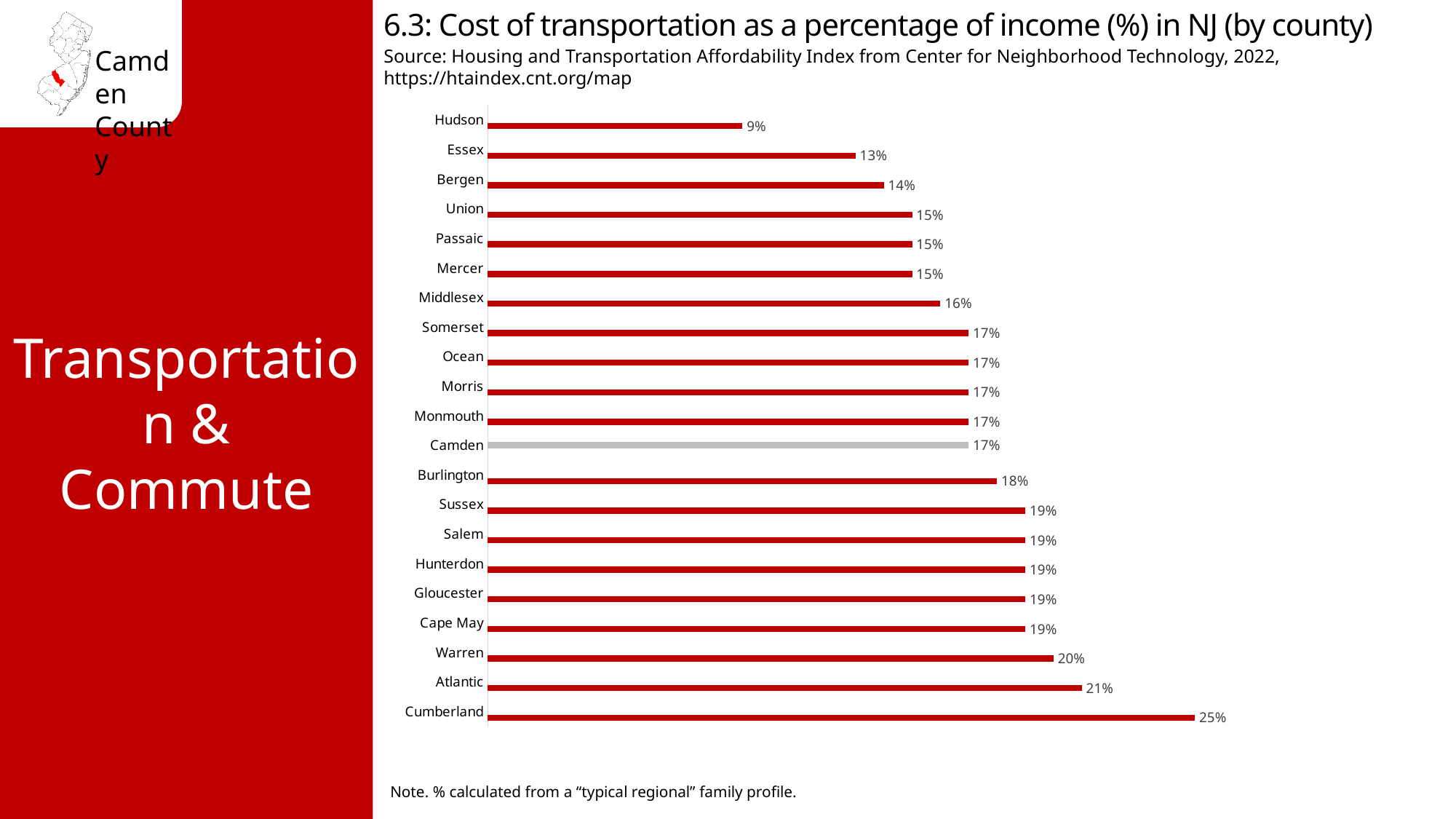
Which county has the lowest cost of transportation as a percentage of income? Hudson What is the value shown for Atlantic County? 21% Which county's bar is shown in grey rather than red? Camden Which county has the highest cost of transportation as a percentage of income? Cumberland How many counties are shown in the chart? 21 What is the difference between the values for Cumberland and Hudson? 16 percentage points Which has a higher value, Middlesex or Bergen? Middlesex What is the value shown for Hudson County? 9% What kind of chart is shown on the slide? Bar chart Which has a higher value, Essex or Burlington? Burlington What is the cost of transportation as a percentage of income for Camden County? 17% What is the difference between the values for Warren and Camden? 3 percentage points